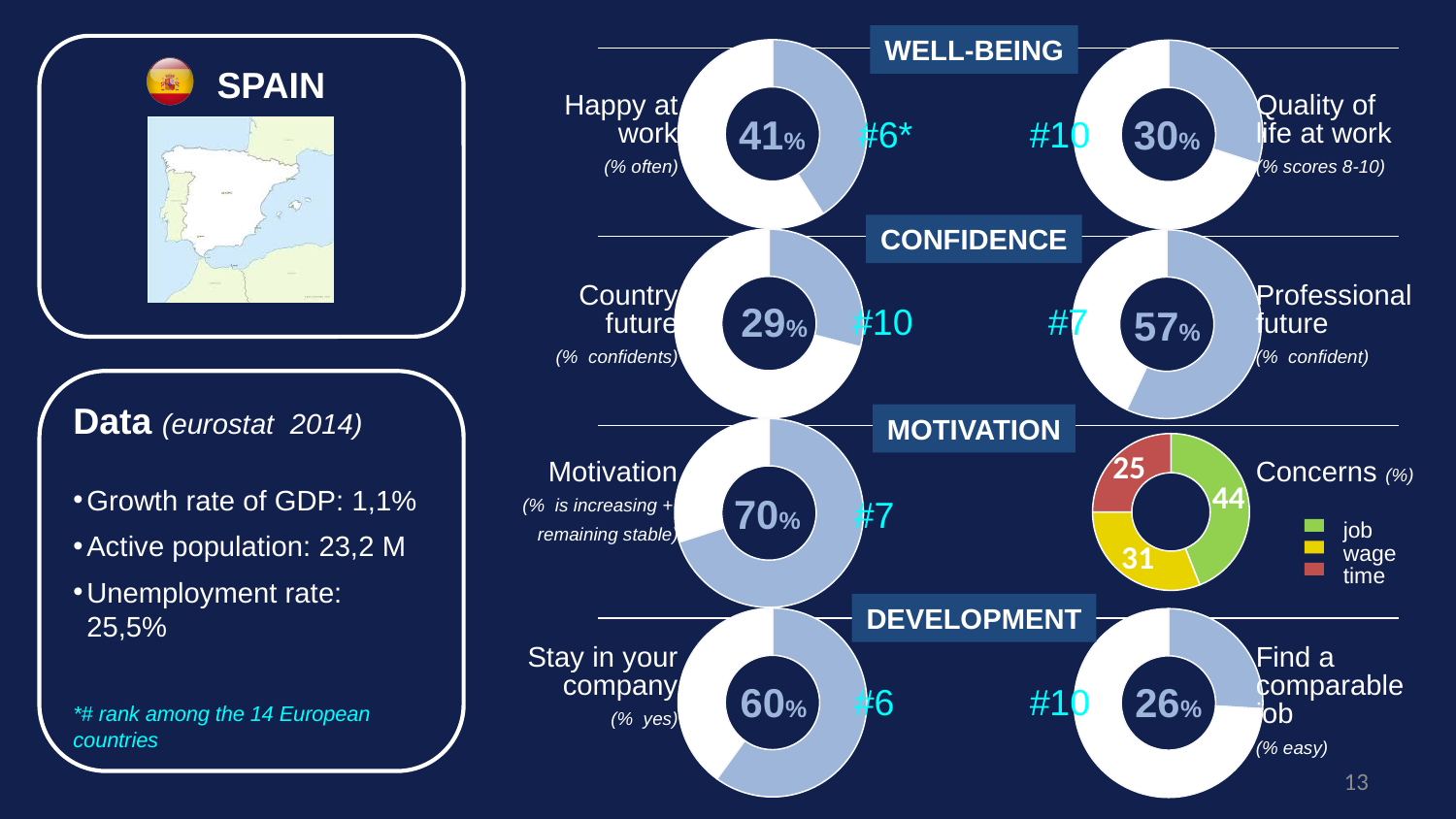
In the "Concerns" chart, which concern has the smallest slice? time In the "Concerns" chart, what value is shown for the "job" slice? 44 Which is larger: the "Country future" percentage or the "Professional future" percentage? Professional future In the "Concerns" chart, what colour represents "wage"? Yellow In the "Quality of life at work" donut chart, what percentage is shown? 30% In the "Concerns" chart, how many categories does the legend list? 3 In the "Professional future" donut chart, what percentage of respondents are confident? 57% In the "Concerns" chart, what is the difference between the "job" and "wage" values? 13 What kind of chart is the "Concerns" chart? Donut chart What is the difference between the "Stay in your company" percentage and the "Find a comparable job" percentage? 34% In the "Concerns" chart, which concern has the largest slice? job In the "Happy at work" donut chart, what percentage is shown in the centre? 41%